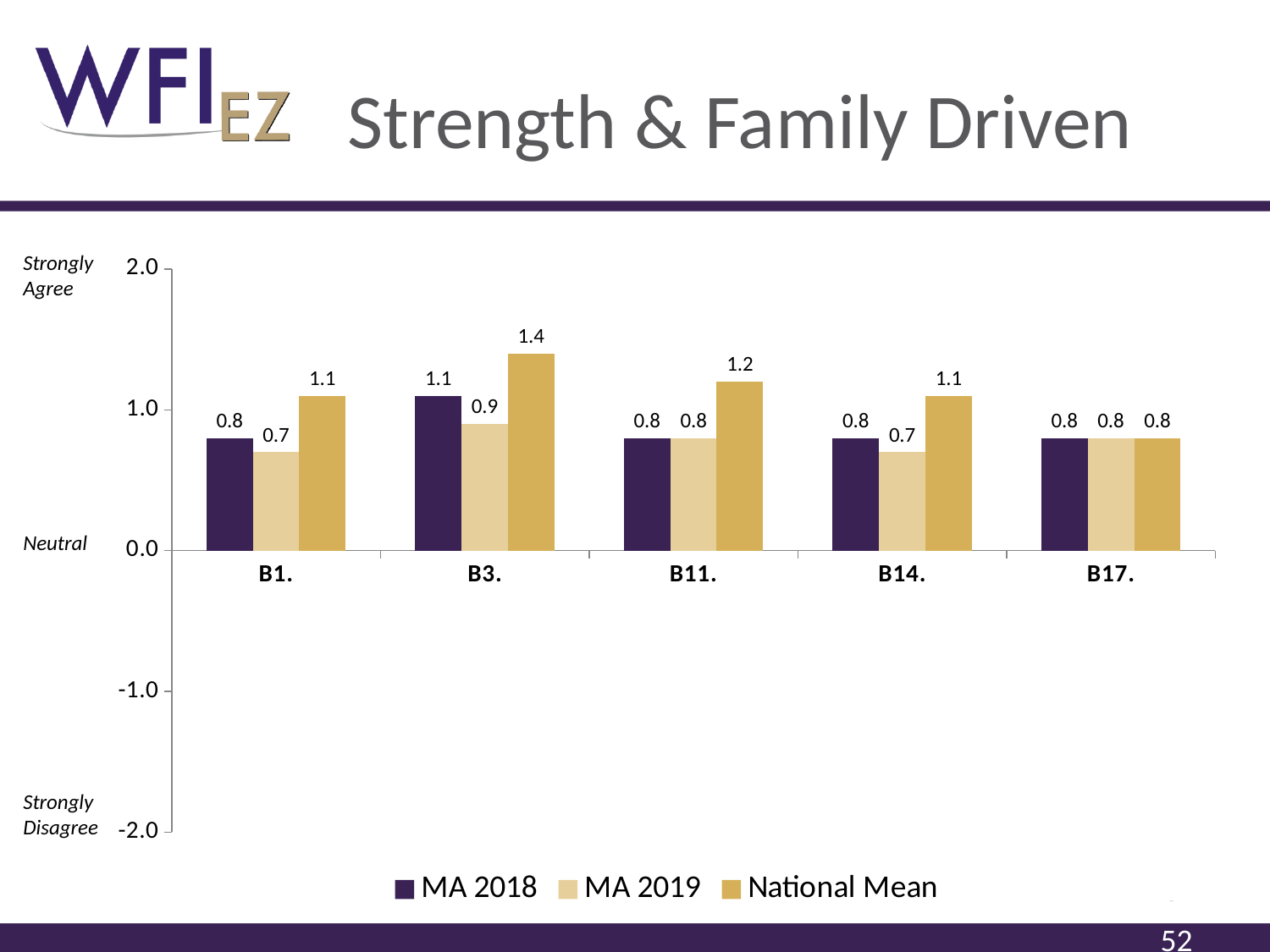
How many categories are shown on the x axis? 5 What is the National Mean value for B11.? 1.2 How many series does the legend list? 3 What is the MA 2018 value for B3.? 1.1 Which category has the highest National Mean value? B3. What is the MA 2019 value for B14.? 0.7 Which category has the highest MA 2018 value? B3. Is the National Mean value for B3. greater or less than 1.0? greater What is the difference between the National Mean and MA 2019 values for B3.? 0.5 What label appears at the 0.0 point of the y axis? Neutral What kind of chart is shown on the slide? bar chart Which is larger for B1., the MA 2018 value or the National Mean value? National Mean